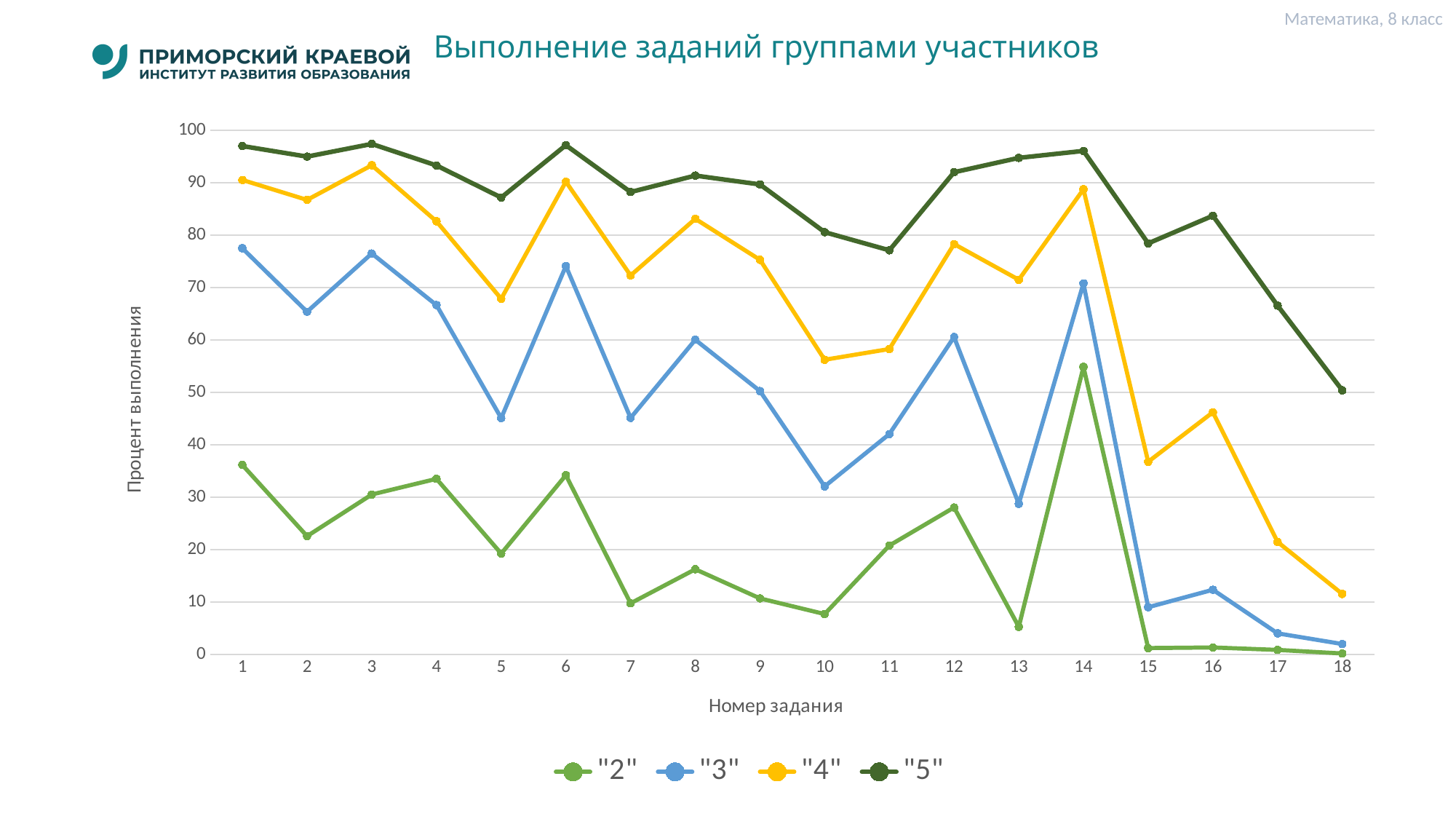
What is the label of the vertical axis? Процент выполнения At task 14, which series has the higher value: "4" or "3"? "4" Is the value for series "2" at task 18 greater or less than 10? less How many series does the legend list? 4 For series "5", at which task number is the value lowest? 18 How many task numbers are plotted along the x axis? 18 What is the title of the chart? Выполнение заданий группами участников For series "2", at which task number is the value highest? 14 Is the value for series "4" at task 6 greater or less than 80? greater Is the value for series "3" at task 10 greater or less than 40? less What kind of chart is shown on the slide? line chart